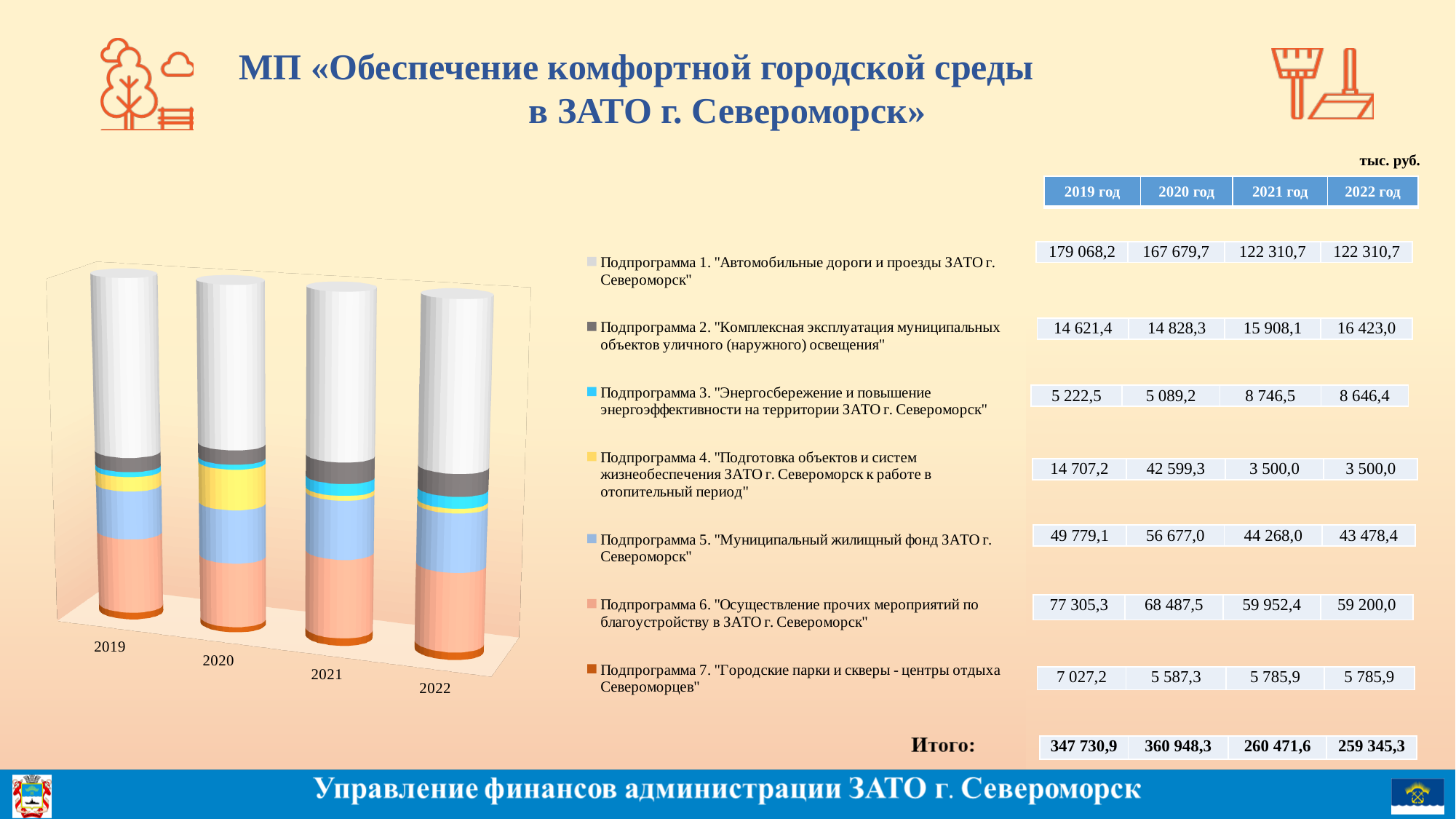
What colour represents Подпрограмма 7 in the chart legend? Orange How many series (subprograms) does the chart legend list? 7 By how much does the value for Подпрограмма 4 in 2020 год exceed its value in 2019 год? 27 892,1 What kind of chart is shown on the slide? Stacked bar chart Which year has the highest total (Итого)? 2020 год Which is larger for Подпрограмма 6: the value in 2019 год or in 2020 год? 2019 год Do the values for Подпрограмма 2 rise or fall from 2019 to 2022? Rise Which year has the lowest total (Итого)? 2022 год What is the value for Подпрограмма 1 in 2019 год? 179 068,2 How many years (categories) are plotted along the x axis of the chart? 4 What is the value for Подпрограмма 3 in 2021 год? 8 746,5 What is the total (Итого) for 2020 год? 360 948,3